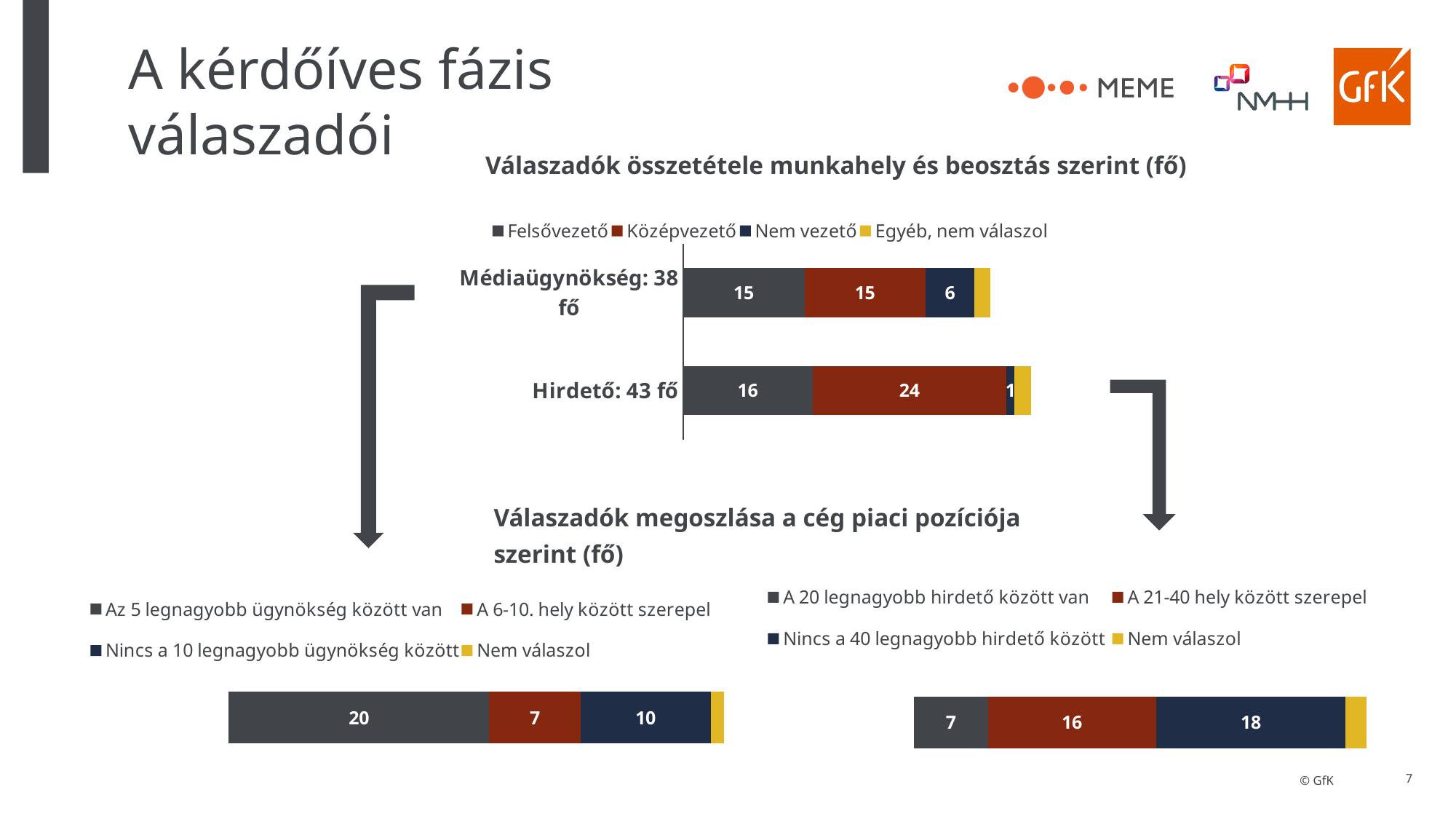
In the bottom-left chart, what is the value for 'Az 5 legnagyobb ügynökség között van'? 20 What kind of chart is the top chart 'Válaszadók összetétele munkahely és beosztás szerint (fő)'? Stacked bar chart In the top chart 'Válaszadók összetétele munkahely és beosztás szerint (fő)', what is the Nem vezető value for Hirdető? 1 In the top chart 'Válaszadók összetétele munkahely és beosztás szerint (fő)', which has the larger Felsővezető value, Médiaügynökség or Hirdető? Hirdető In the top chart 'Válaszadók összetétele munkahely és beosztás szerint (fő)', what is the Középvezető value for Hirdető? 24 In the top chart 'Válaszadók összetétele munkahely és beosztás szerint (fő)', what is the total number of respondents shown for the Hirdető bar? 43 fő In the bottom-right chart, what is the value for 'Nincs a 40 legnagyobb hirdető között'? 18 In the bottom-left chart, which labelled segment has the lowest value? A 6-10. hely között szerepel In the top chart 'Válaszadók összetétele munkahely és beosztás szerint (fő)', what is the Felsővezető value for Médiaügynökség? 15 In the top chart 'Válaszadók összetétele munkahely és beosztás szerint (fő)', what is the Nem vezető value for Médiaügynökség? 6 How many series does the legend of the top chart 'Válaszadók összetétele munkahely és beosztás szerint (fő)' list? 4 In the top chart 'Válaszadók összetétele munkahely és beosztás szerint (fő)', what is the difference between the Középvezető values for Hirdető and Médiaügynökség? 9